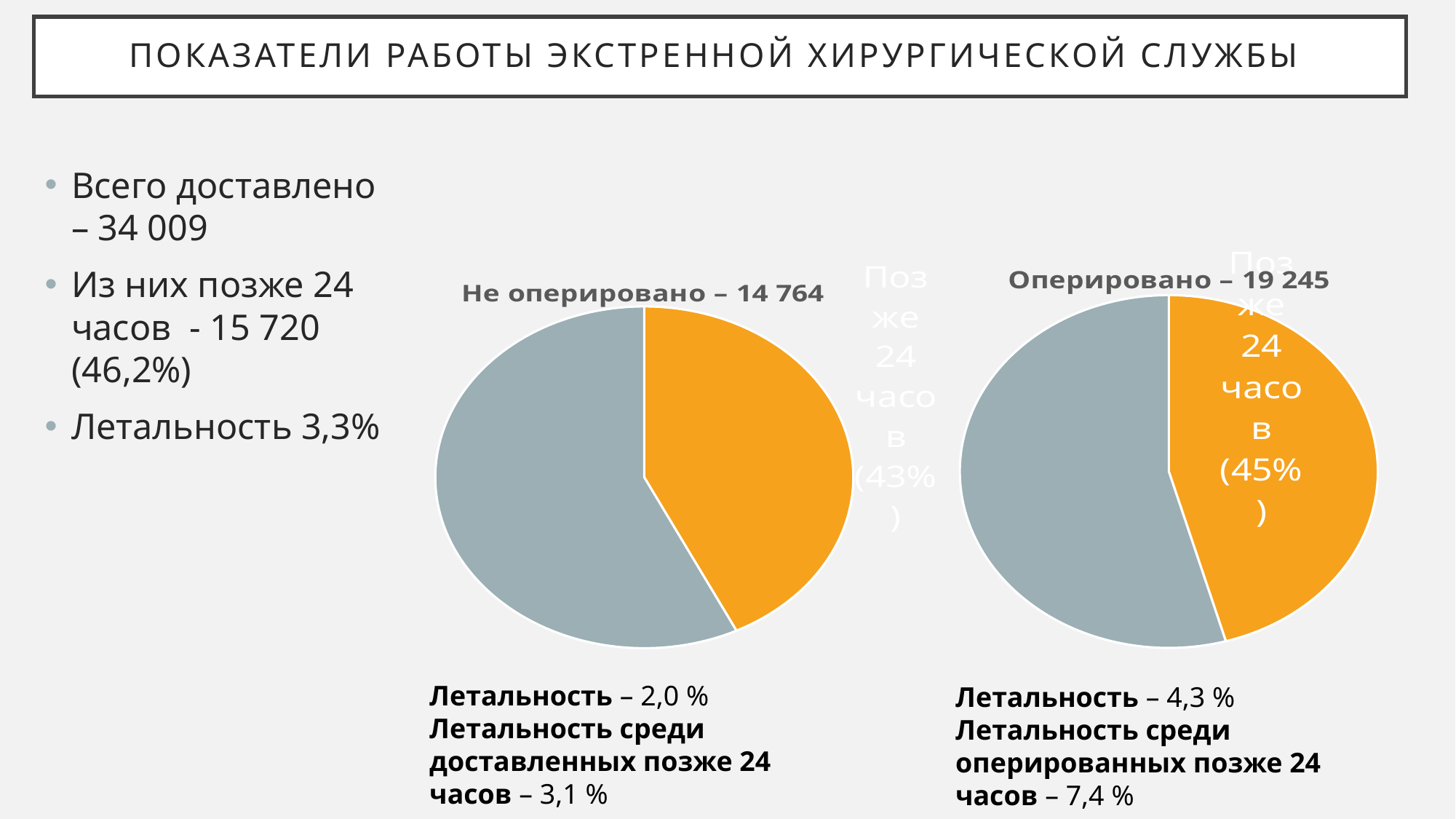
In the right pie chart "Оперировано – 19 245", what share does the "Позже 24 часов" slice represent? 45% In the left pie chart "Не оперировано – 14 764", what share does the "Позже 24 часов" slice represent? 43% What kind of chart is the left chart titled "Не оперировано – 14 764"? pie chart How many slices does the left pie chart "Не оперировано – 14 764" have? 2 How many slices does the right pie chart "Оперировано – 19 245" have? 2 What is the title of the left pie chart? Не оперировано – 14 764 What is the difference between the "Позже 24 часов" share in the right pie chart (45%) and in the left pie chart (43%)? 2% In the left pie chart "Не оперировано – 14 764", is the "Позже 24 часов" share greater or less than 50%? less In the right pie chart "Оперировано – 19 245", which slice is larger, the orange "Позже 24 часов" slice or the grey slice? the grey slice Which pie chart has the larger "Позже 24 часов" share, "Не оперировано – 14 764" or "Оперировано – 19 245"? Оперировано – 19 245 What is the title of the right pie chart? Оперировано – 19 245 In the left pie chart "Не оперировано – 14 764", which slice is larger, the orange "Позже 24 часов" slice or the grey slice? the grey slice